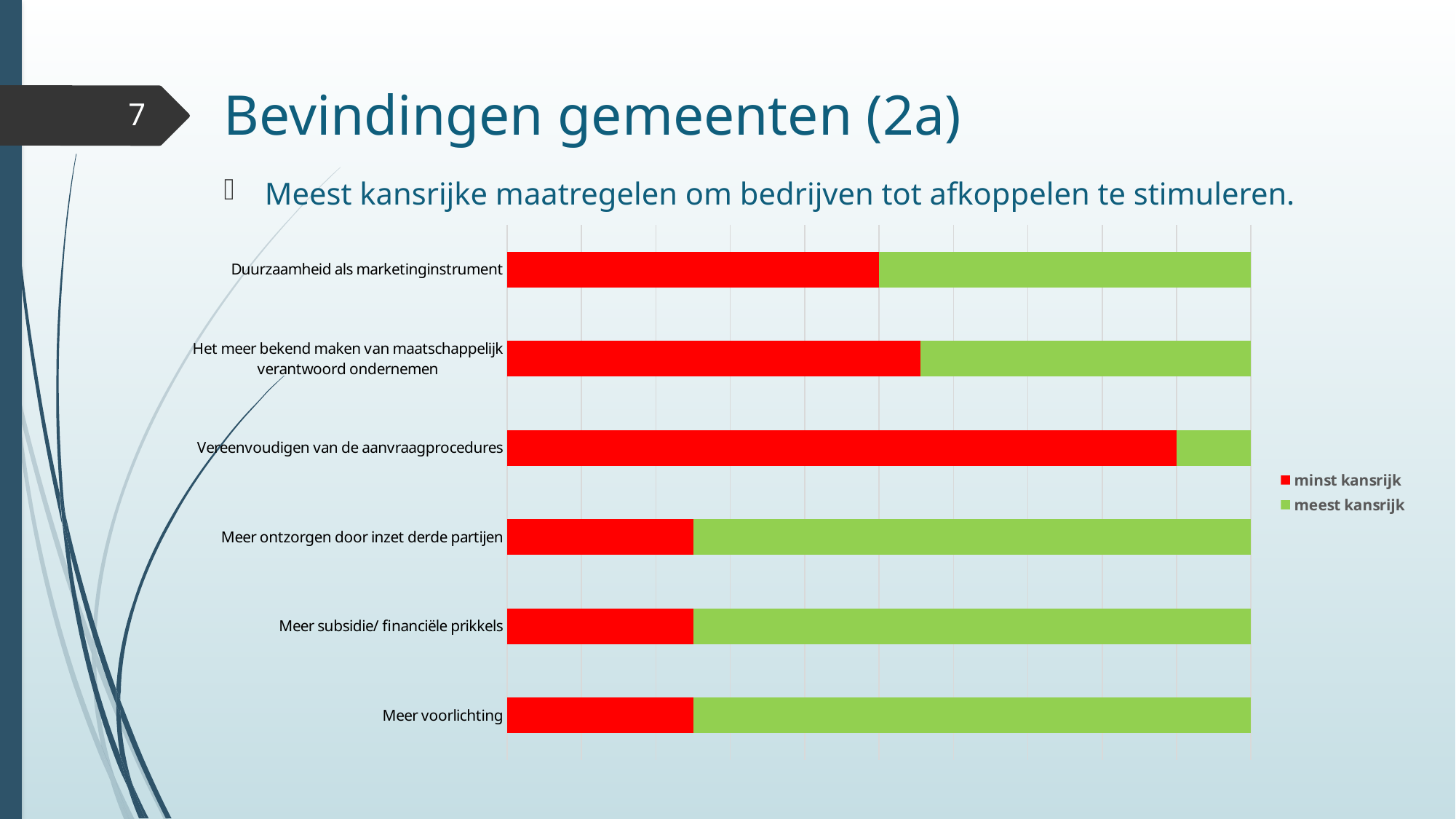
How many categories (measures) are listed on the chart's vertical axis? 6 Which has the larger 'meest kansrijk' share: Meer ontzorgen door inzet derde partijen or Duurzaamheid als marketinginstrument? Meer ontzorgen door inzet derde partijen How many series does the chart legend list? 2 What kind of chart is shown on the slide? Stacked bar chart Which has the larger 'minst kansrijk' share: Vereenvoudigen van de aanvraagprocedures or Meer voorlichting? Vereenvoudigen van de aanvraagprocedures Which category has the smallest 'meest kansrijk' (green) share? Vereenvoudigen van de aanvraagprocedures What are the two series named in the legend? minst kansrijk and meest kansrijk Which category is listed at the top of the chart? Duurzaamheid als marketinginstrument Which colour represents the 'meest kansrijk' series? Green For Meer subsidie/ financiële prikkels, which segment is larger: 'minst kansrijk' or 'meest kansrijk'? meest kansrijk Which category has the largest 'minst kansrijk' (red) share? Vereenvoudigen van de aanvraagprocedures